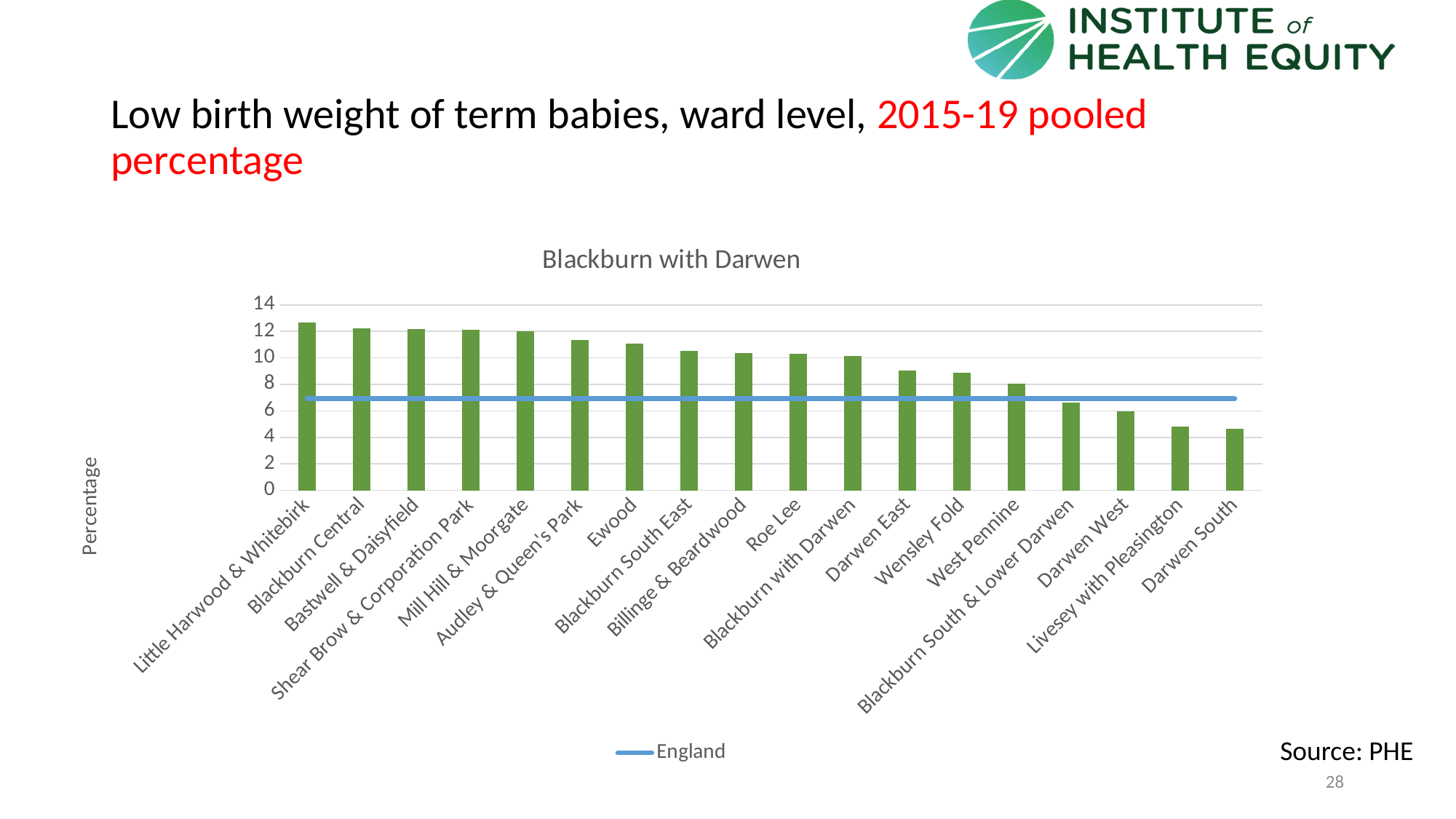
Is the value for Darwen South greater or less than 6? less Which has the larger value, Ewood or Darwen East? Ewood Is the value for Blackburn South & Lower Darwen greater or less than 8? less Is the value for Ewood greater or less than 10? greater Which category has the highest bar in the chart? Little Harwood & Whitebirk What is the title of the chart? Blackburn with Darwen Which has the larger value, Roe Lee or Darwen West? Roe Lee What entry does the chart's legend list? England What kind of chart is shown on the slide? Combination bar and line chart How many wards/categories are plotted along the x axis of the chart? 18 Do the bar values rise or fall moving from left to right along the x axis? Fall